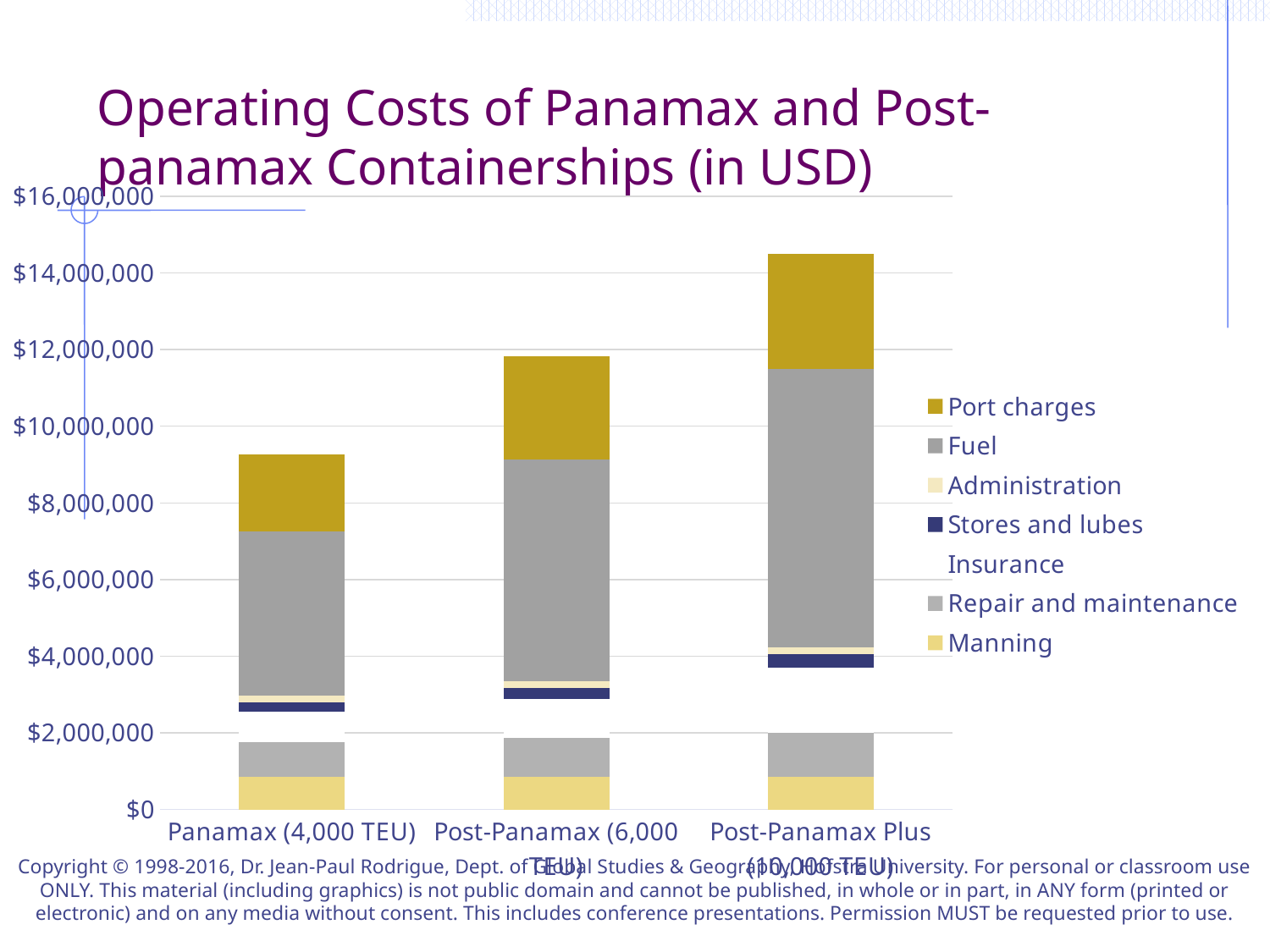
Which ship category has the lowest total operating cost? Panamax (4,000 TEU) Is the total operating cost for Post-Panamax Plus greater or less than $14,000,000? greater How many ship categories are plotted on the x axis? 3 Do total operating costs rise or fall moving from Panamax to Post-Panamax Plus along the x axis? Rise Which has a larger total operating cost, Panamax (4,000 TEU) or Post-Panamax (6,000 TEU)? Post-Panamax (6,000 TEU) Which series is listed first in the legend? Port charges What is the title of the chart? Operating Costs of Panamax and Post-panamax Containerships (in USD) Which ship category has the highest total operating cost? Post-Panamax Plus Is the total operating cost for Post-Panamax (6,000 TEU) greater or less than $12,000,000? less Is the total operating cost for Panamax (4,000 TEU) greater or less than $10,000,000? less What kind of chart is shown on the slide? Stacked bar chart How many series does the legend list? 7